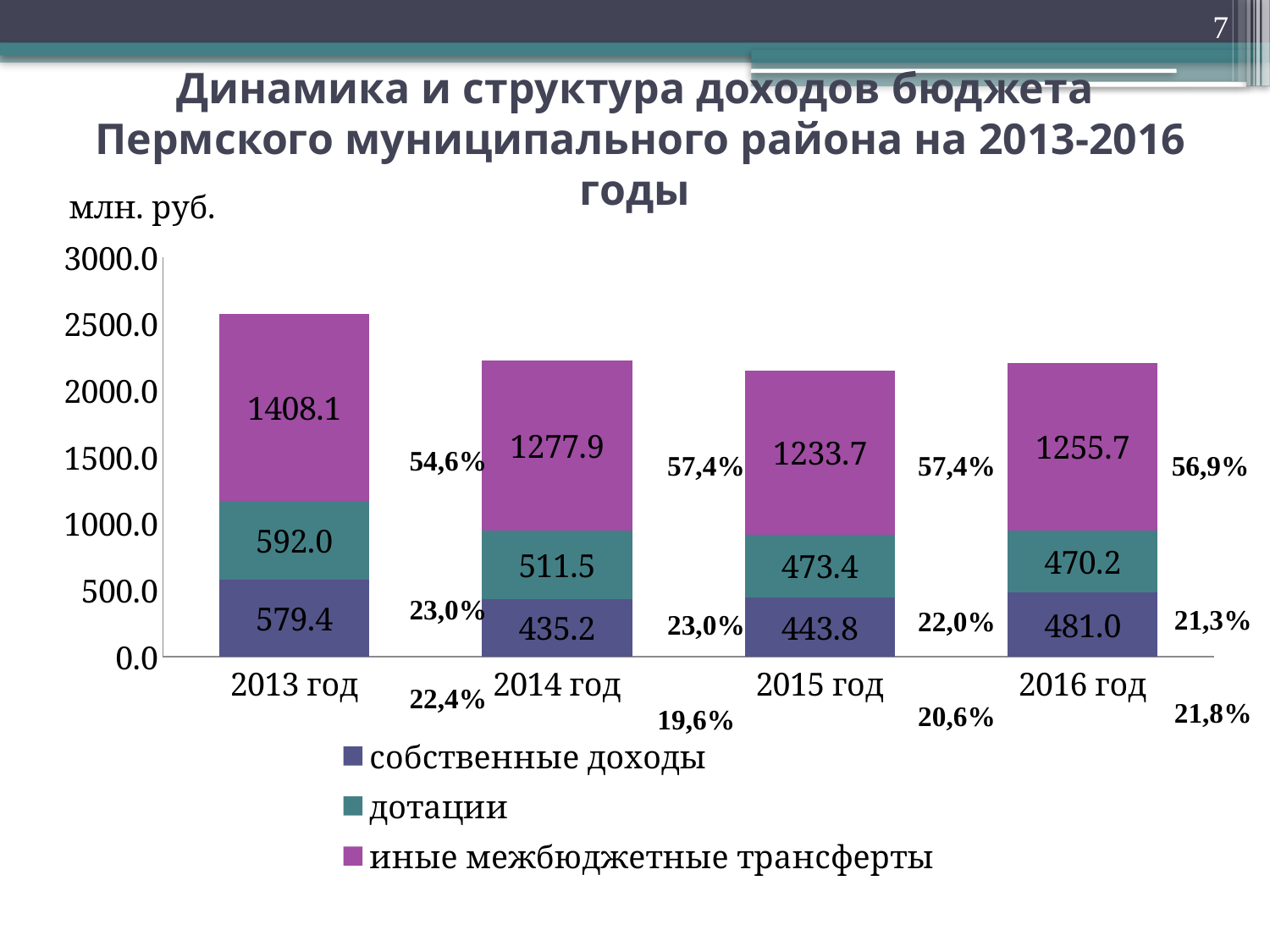
In which year is the value of 'иные межбюджетные трансферты' highest? 2013 год What is the value of 'дотации' for 2015 год? 473.4 What is the total of the stacked bar for 2014 год? 2224.6 What is the value of 'собственные доходы' for 2013 год? 579.4 How many series does the legend list? 3 What type of chart is shown on the slide? stacked bar chart How many years (categories) are shown on the x axis? 4 In which year is the value of 'собственные доходы' lowest? 2014 год Is the total of the stacked bar for 2013 год greater or less than 2500.0? greater What is the difference between 'иные межбюджетные трансферты' in 2013 год and 2014 год? 130.2 Which is larger: 'дотации' in 2013 год or 'дотации' in 2016 год? 2013 год What is the value of 'иные межбюджетные трансферты' for 2016 год? 1255.7